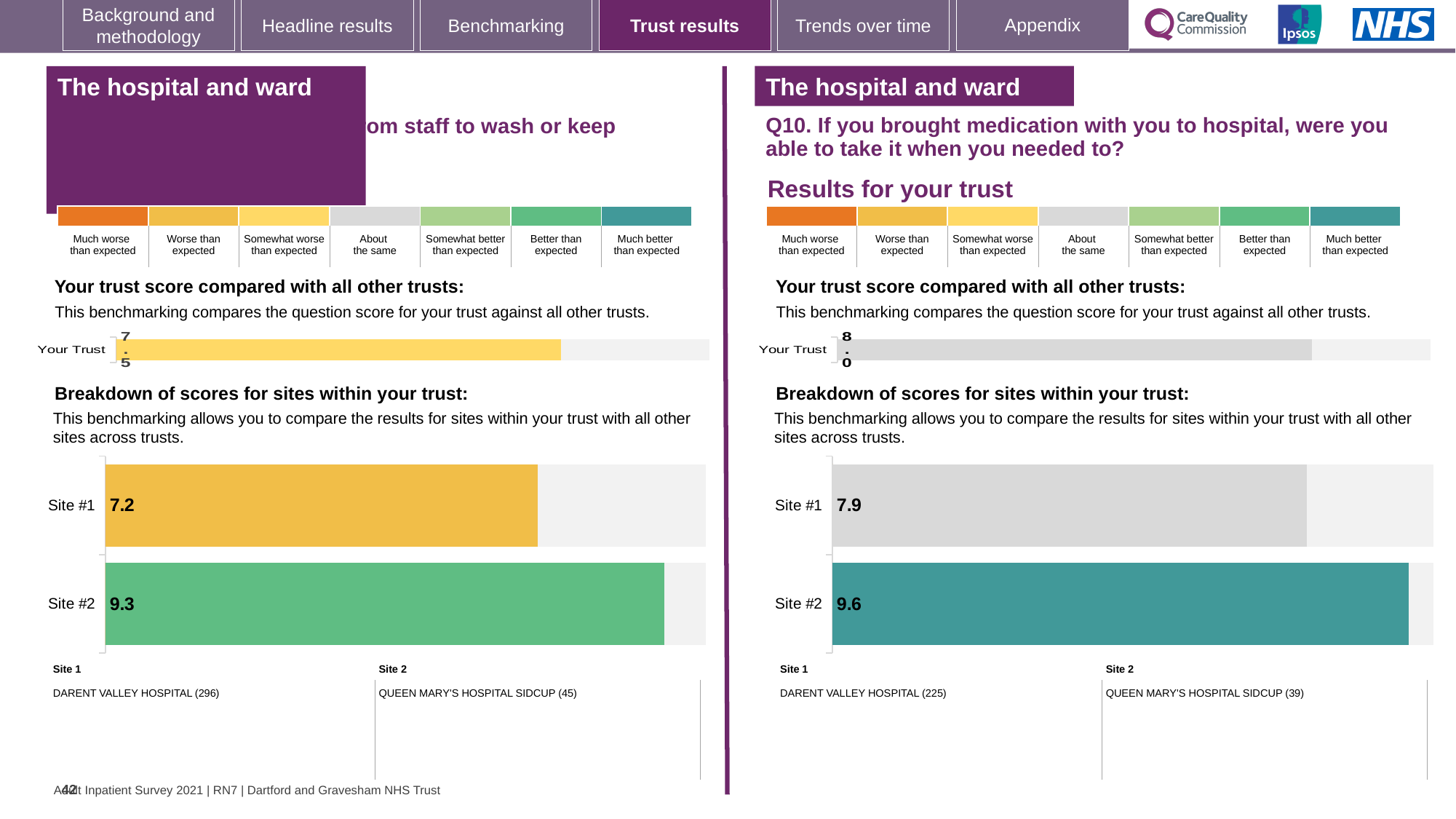
On the right-hand slide (Q10), what is the score for Site #1 in the breakdown of scores for sites within your trust? 7.9 On the right-hand slide (Q10), what is the score for Site #2 in the breakdown of scores for sites within your trust? 9.6 On the left-hand slide, what is the 'Your Trust' score shown in the trust score comparison chart? 7.5 On the right-hand slide (Q10), what is the difference between the Site #2 and Site #1 scores in the site breakdown chart? 1.7 On the right-hand slide (Q10), what is the 'Your Trust' score shown in the trust score comparison chart? 8.0 On the left-hand slide, what is the score for Site #1 in the breakdown of scores for sites within your trust? 7.2 What type of chart is used for the breakdown of scores for sites within your trust on the left-hand slide? Bar chart On the left-hand slide, which site has the lower score in the site breakdown chart? Site #1 On the right-hand slide (Q10), which site has the higher score in the site breakdown chart? Site #2 On the left-hand slide, what is the score for Site #2 in the breakdown of scores for sites within your trust? 9.3 On the left-hand slide, what is the difference between the Site #2 and Site #1 scores in the site breakdown chart? 2.1 How many sites are shown in the site breakdown chart on the right-hand slide (Q10)? 2